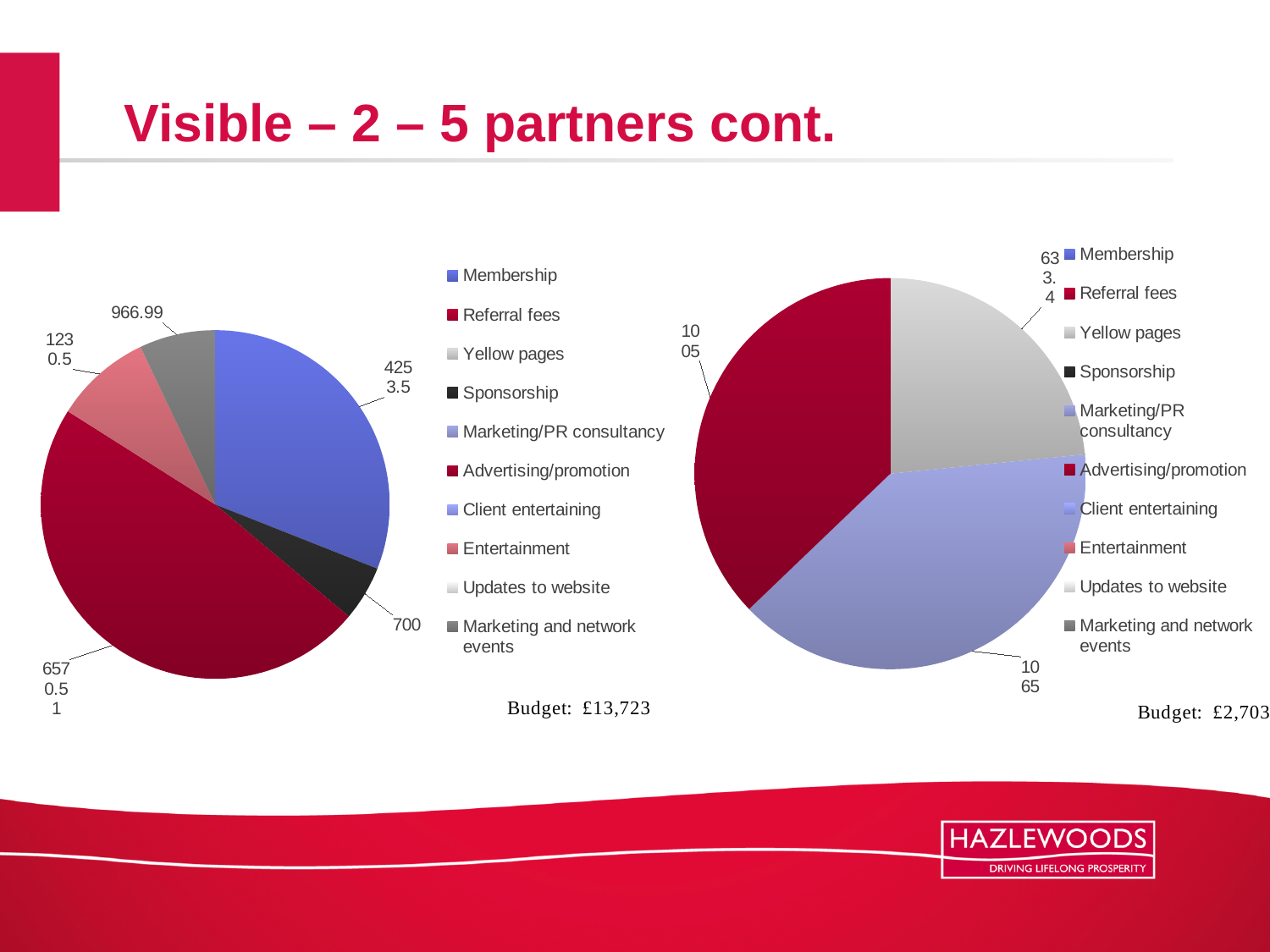
In the right chart (Budget: £2,703), what is the value for Marketing/PR consultancy? 1065 In the left chart (Budget: £13,723), which category has the smallest slice? Sponsorship In the right chart (Budget: £2,703), which category has the smallest slice? Yellow pages In the left chart (Budget: £13,723), what is the value for Sponsorship? 700 In the left chart (Budget: £13,723), which category has the largest slice? Advertising/promotion In the left chart (Budget: £13,723), what is the value for Marketing and network events? 966.99 In the right chart (Budget: £2,703), how many slices does the pie have? 3 What kind of chart is the left chart (Budget: £13,723)? Pie chart How many entries does the legend of the right chart (Budget: £2,703) list? 10 In the right chart (Budget: £2,703), what is the difference between the values for Marketing/PR consultancy and Advertising/promotion? 60 In the right chart (Budget: £2,703), what is the value for Advertising/promotion? 1005 In the left chart (Budget: £13,723), how many slices does the pie have? 5